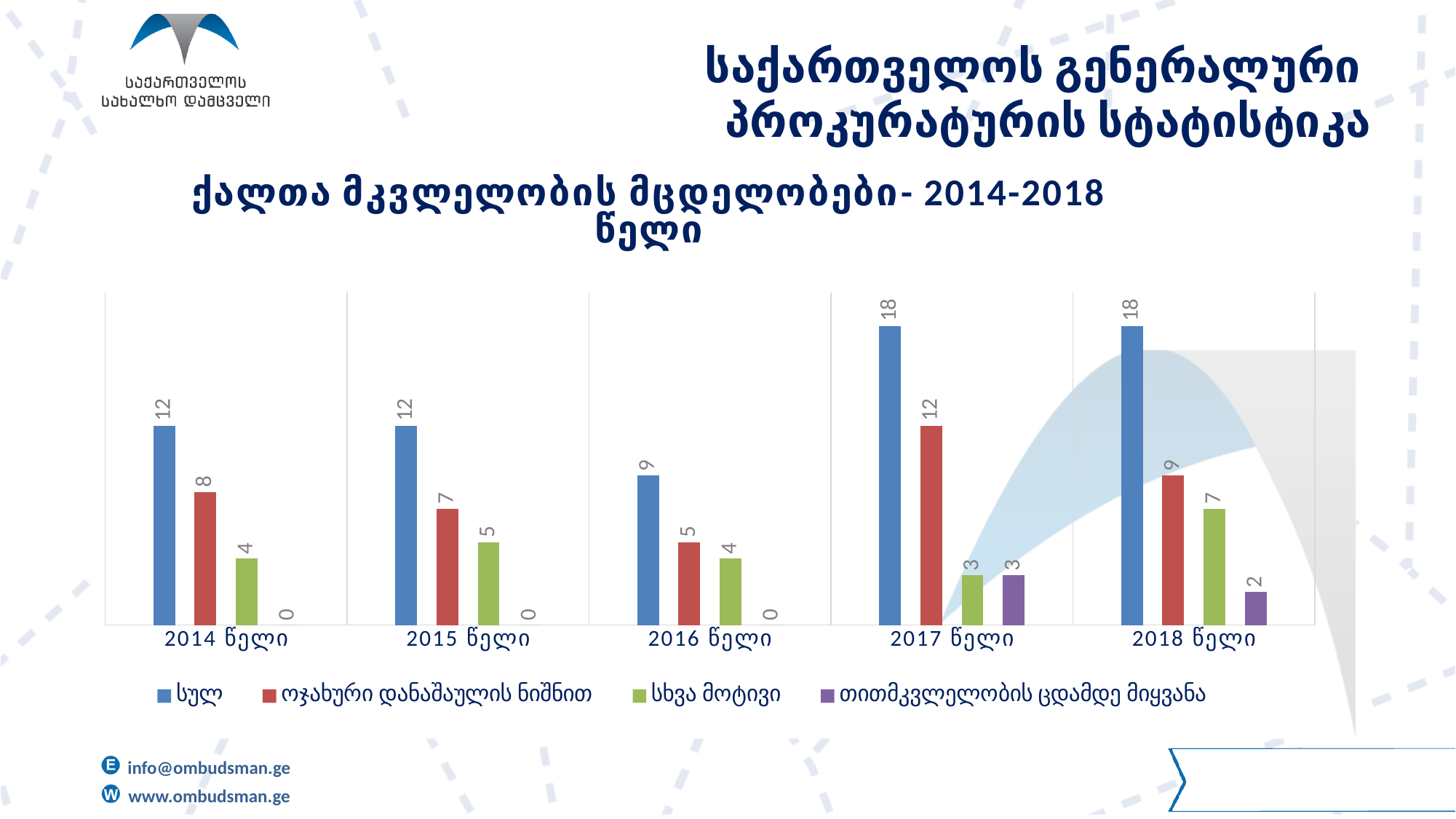
What is the value of ოჯახური დანაშაულის ნიშნით for 2018 წელი? 9 Which colour represents სულ in the legend? Blue What is the value of სულ for 2017 წელი? 18 How many years are shown on the x axis? 5 How many series does the legend list? 4 Which year has the lowest value for სულ? 2016 წელი What is the value of სხვა მოტივი for 2015 წელი? 5 What kind of chart is shown on the slide? Bar chart Which year has the highest value for ოჯახური დანაშაულის ნიშნით? 2017 წელი Which is larger in 2018 წელი: სხვა მოტივი or თვითმკვლელობის ცდამდე მიყვანა? სხვა მოტივი What is the value of თვითმკვლელობის ცდამდე მიყვანა for 2014 წელი? 0 What is the difference between სულ and ოჯახური დანაშაულის ნიშნით in 2016 წელი? 4